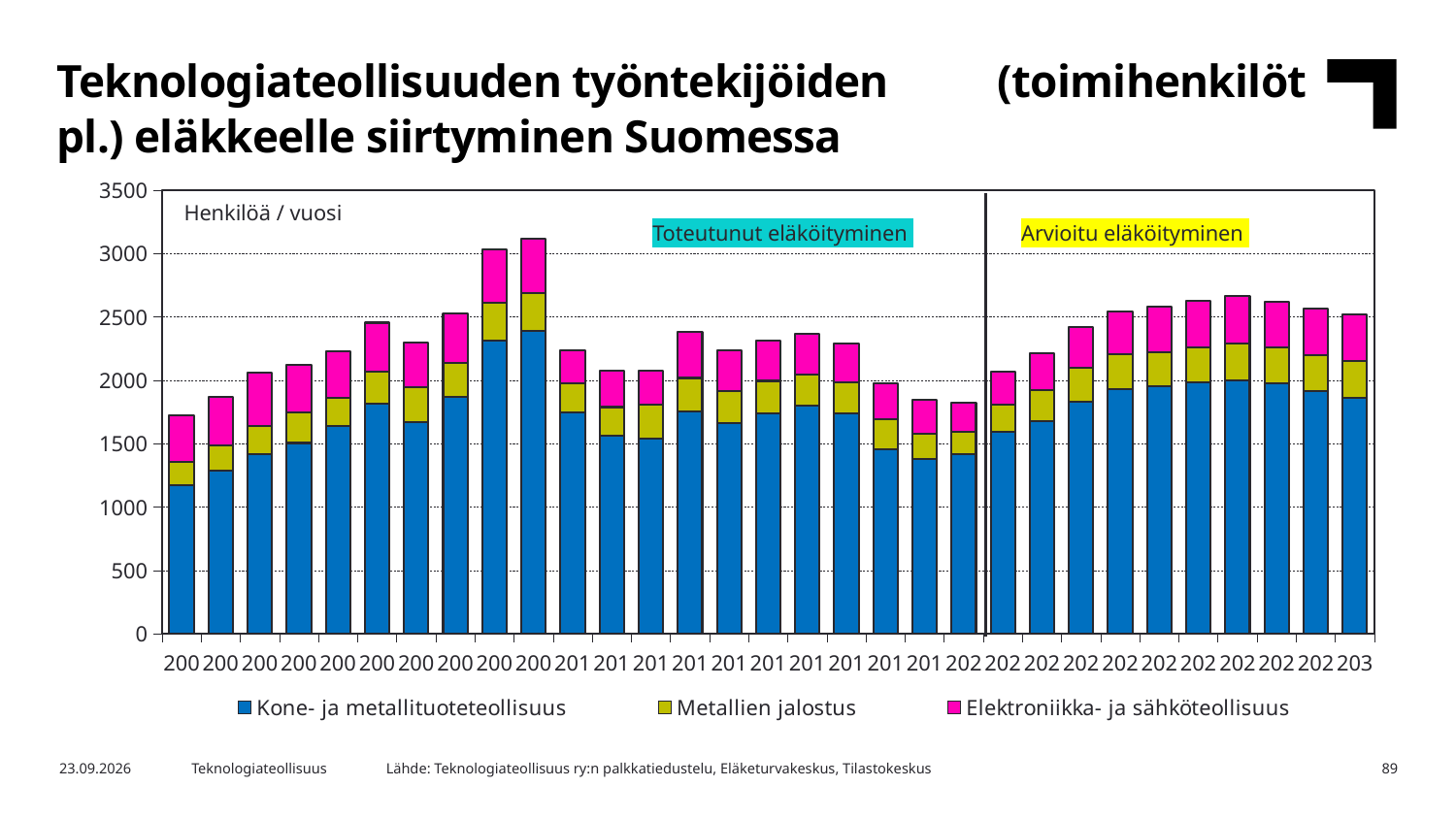
What kind of chart is shown on the slide? Stacked bar chart Is the bottom (blue) segment of the leftmost bar greater or less than 1500? less How many bars are plotted in the chart? 31 What are the three series listed in the legend? Kone- ja metallituoteteollisuus, Metallien jalostus, Elektroniikka- ja sähköteollisuus Is the total of the rightmost bar greater or less than 2000? greater Is the tallest bar in the 'Toteutunut eläköityminen' section or the 'Arvioitu eläköityminen' section? Toteutunut eläköityminen Is the total of the tallest bar greater or less than 3000? greater How many series does the legend list? 3 How many bars are in the 'Arvioitu eläköityminen' section to the right of the vertical line? 10 What unit label is shown inside the chart area at the top left? Henkilöä / vuosi